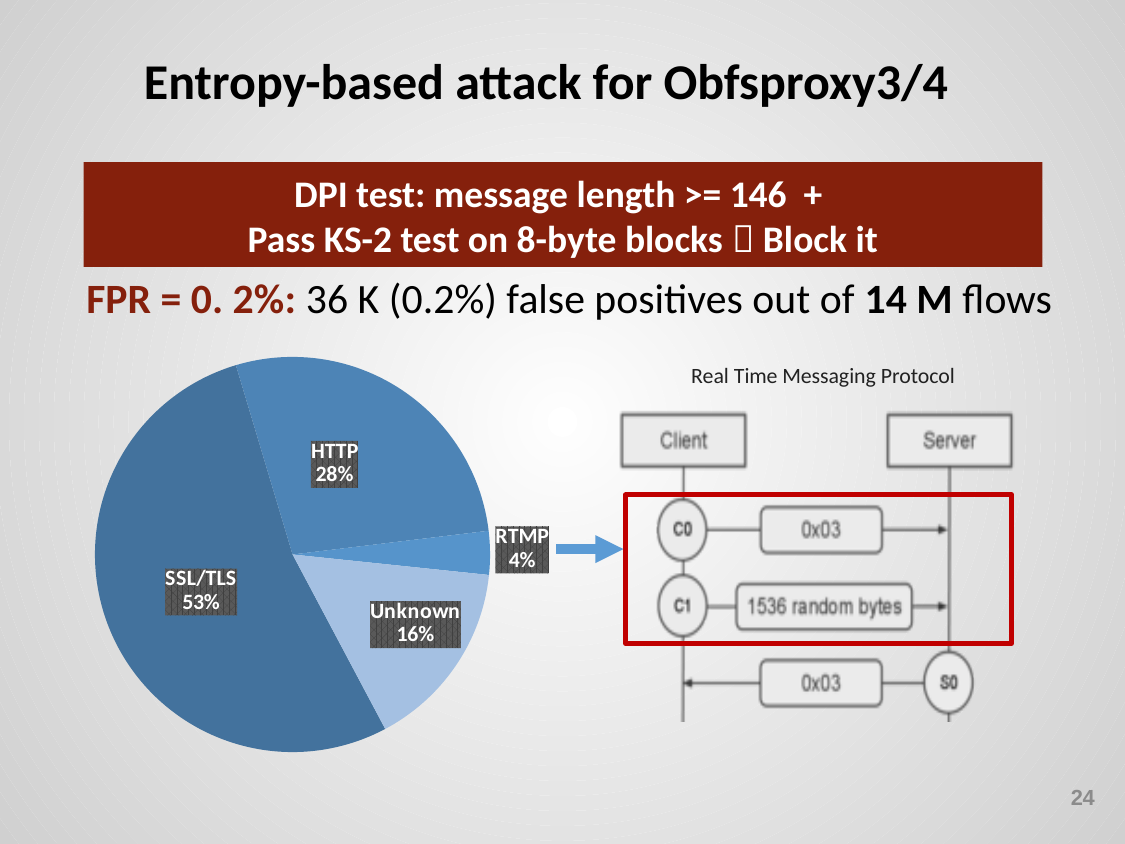
What is the difference in percentage points between SSL/TLS and HTTP? 25 What share of the pie does SSL/TLS account for? 53% Which slice of the pie does the arrow point from toward the protocol diagram? RTMP What is the difference in percentage points between Unknown and RTMP? 12 What kind of chart is shown on the slide? pie chart What is the value shown for Unknown in the pie chart? 16% What is the value shown for HTTP in the pie chart? 28% Which category has the largest slice of the pie? SSL/TLS Which category has the smallest slice of the pie? RTMP Which is larger, the HTTP slice or the Unknown slice? HTTP How many slices does the pie chart have? 4 What is the value shown for RTMP in the pie chart? 4%